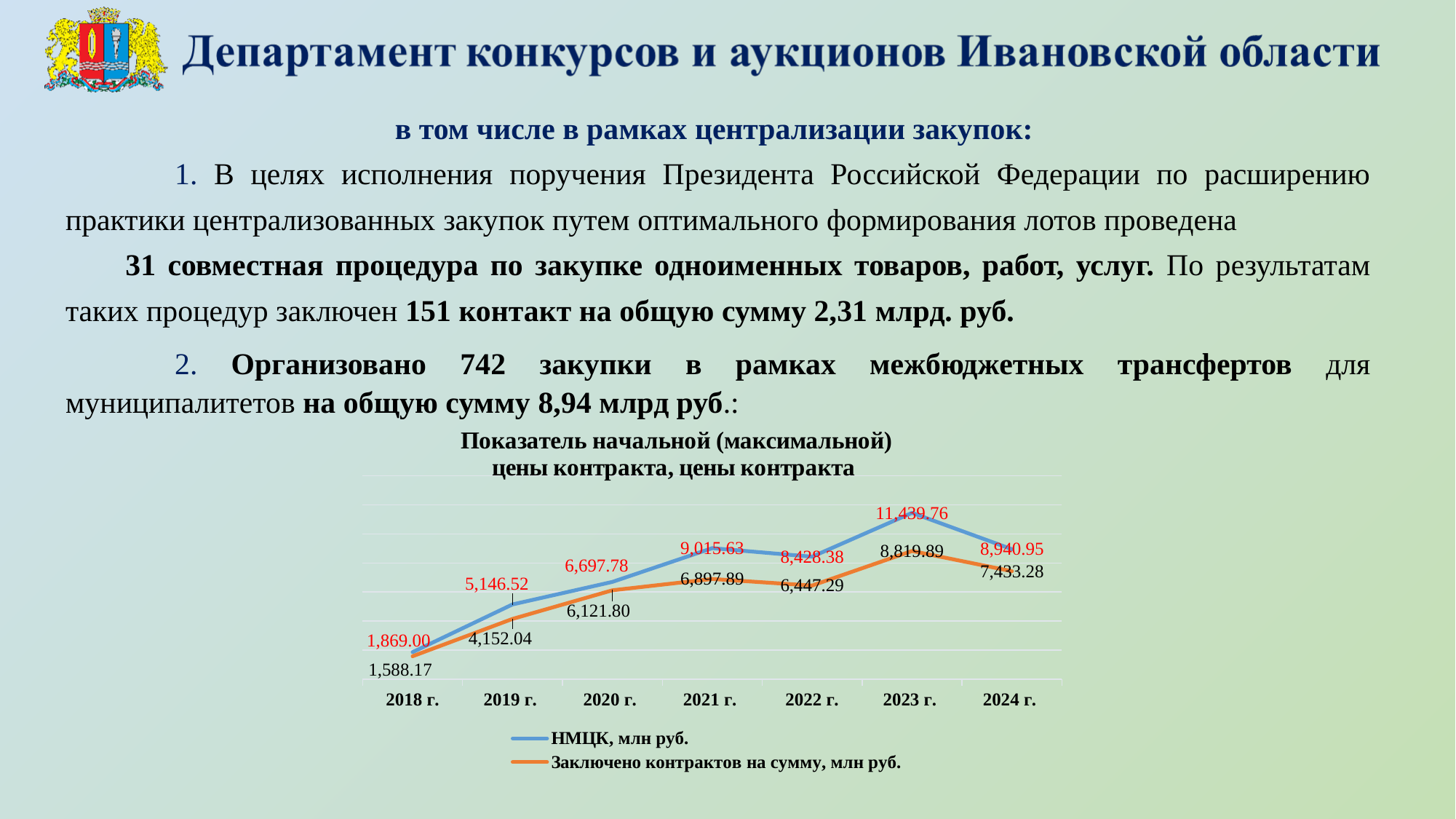
What colour is the line for Заключено контрактов на сумму, млн руб.? Orange In which year is Заключено контрактов на сумму, млн руб. the lowest? 2018 г. Which is larger in 2024 г.: НМЦК, млн руб. or Заключено контрактов на сумму, млн руб.? НМЦК, млн руб. Does НМЦК, млн руб. rise or fall from 2023 г. to 2024 г.? Fall What is the value of НМЦК, млн руб. for 2018 г.? 1,869.00 What is the value of НМЦК, млн руб. for 2023 г.? 11,439.76 How many series does the chart legend list? 2 What is the difference between НМЦК and Заключено контрактов на сумму in 2023 г.? 2,619.87 In which year is НМЦК, млн руб. the highest? 2023 г. How many years are plotted along the x axis of the chart? 7 What is the value of Заключено контрактов на сумму, млн руб. for 2020 г.? 6,121.80 What type of chart is shown on the slide? Line chart